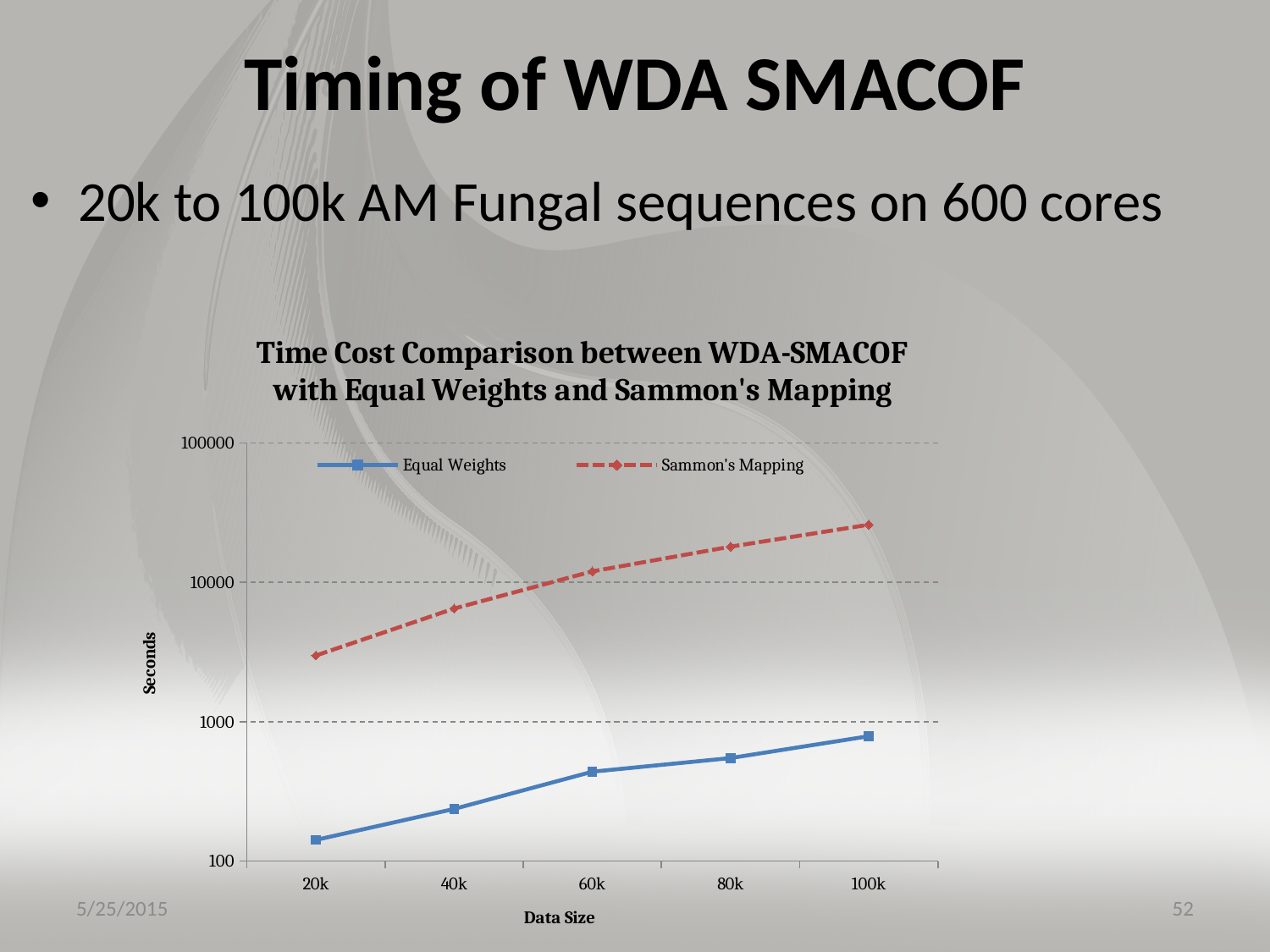
What kind of chart is shown on the slide? Line chart How many data sizes are plotted along the x axis? 5 Do the Equal Weights values rise or fall as the data size increases from 20k to 100k? rise Is the value for Sammon's Mapping at 100k greater or less than 10000? greater Is the value for Equal Weights at 100k greater or less than 1000? less At which data size is the Sammon's Mapping time lowest? 20k At which data size is the Equal Weights time highest? 100k What is the label of the y axis? Seconds Is the value for Sammon's Mapping at 20k greater or less than 10000? less Which series is plotted with a dashed red line? Sammon's Mapping How many series does the legend list? 2 At 60k, which series has the larger time cost, Equal Weights or Sammon's Mapping? Sammon's Mapping